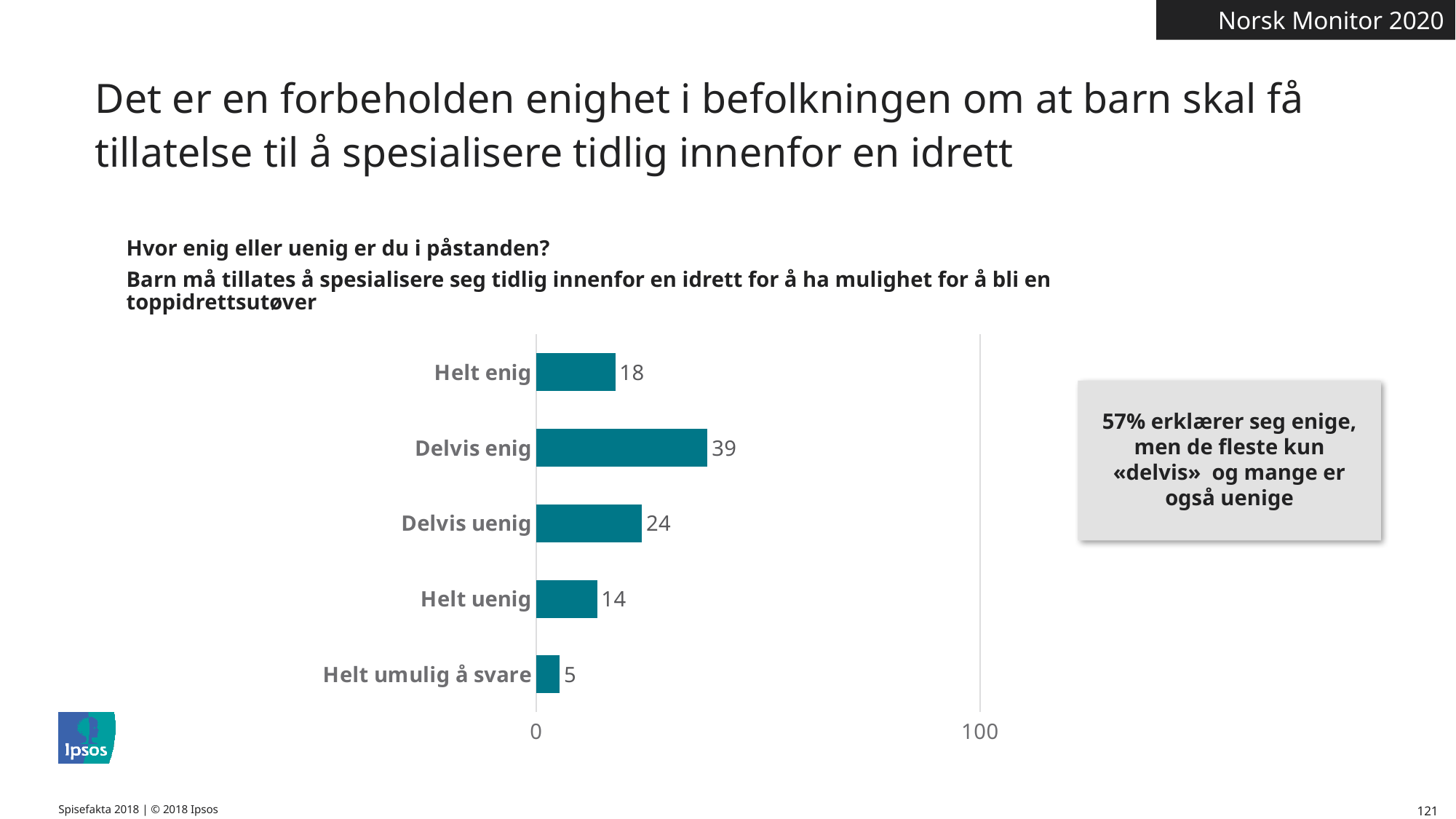
Which category has the highest value? Delvis enig What is the value for "Helt enig"? 18 What is the value for "Helt uenig"? 14 What is the value for "Delvis enig"? 39 Which is larger, the value for "Helt enig" or the value for "Delvis uenig"? Delvis uenig What is the maximum value shown on the chart's axis? 100 How many categories are shown in the chart? 5 What is the value for "Helt umulig å svare"? 5 What kind of chart is shown on the slide? Bar chart What is the combined value of "Helt enig" and "Delvis enig"? 57 What is the difference between the values for "Delvis enig" and "Delvis uenig"? 15 Which category has the lowest value? Helt umulig å svare